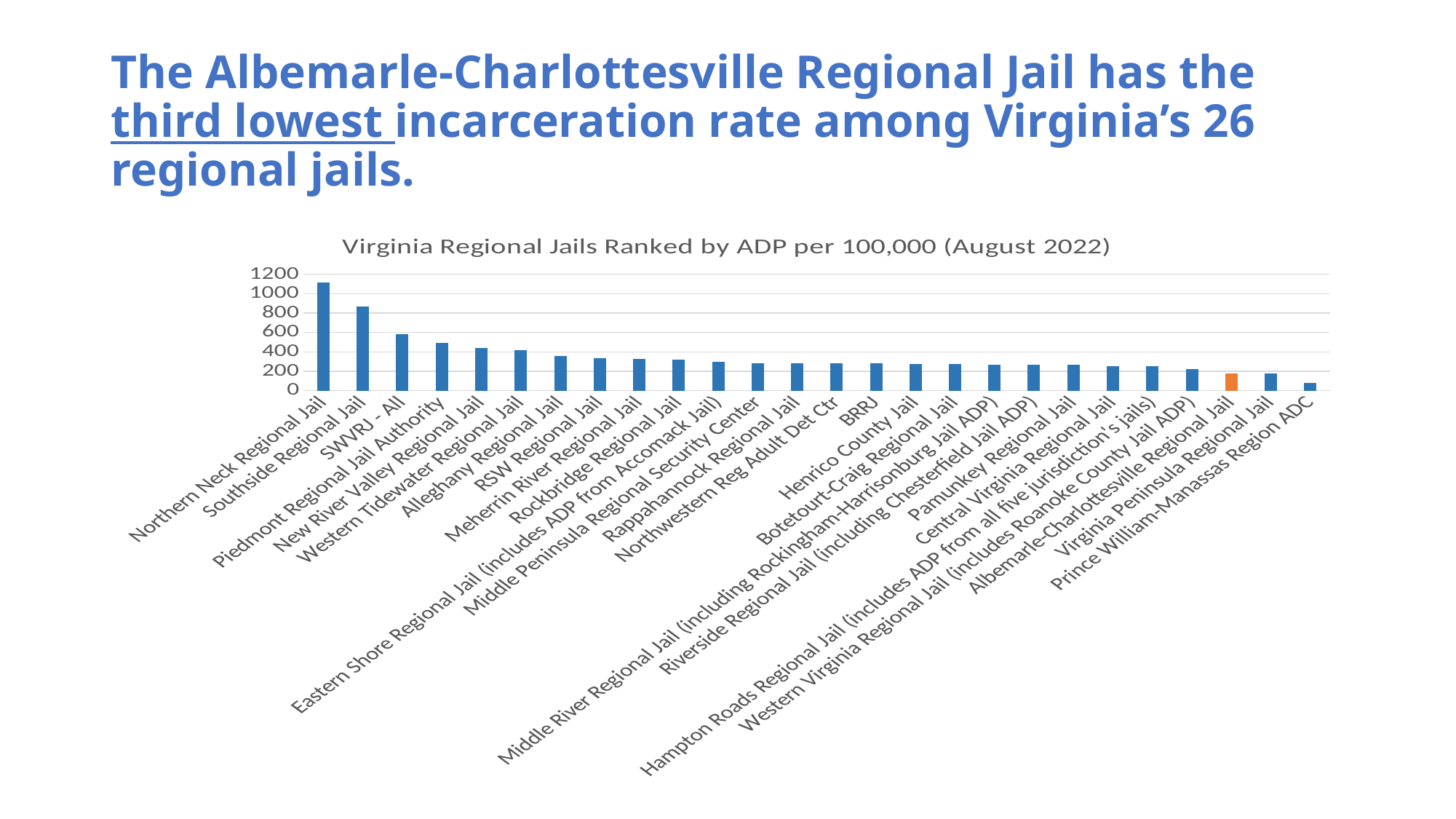
Is the value for SWVRJ - All greater or less than 400? greater Which jail has the lowest ADP per 100,000 in the chart? Prince William-Manassas Region ADC Which jail has the highest ADP per 100,000 in the chart? Northern Neck Regional Jail Is the value for Northern Neck Regional Jail greater or less than 1000? greater Is the value for Southside Regional Jail greater or less than 1000? less What kind of chart is shown on the slide? bar chart Do the bar values rise or fall moving from left to right along the x axis? fall What is the title of the chart? Virginia Regional Jails Ranked by ADP per 100,000 (August 2022) Which has a larger value, Northern Neck Regional Jail or Southside Regional Jail? Northern Neck Regional Jail Which jail's bar is highlighted in orange in the chart? Albemarle-Charlottesville Regional Jail How many regional jails are plotted in the chart? 26